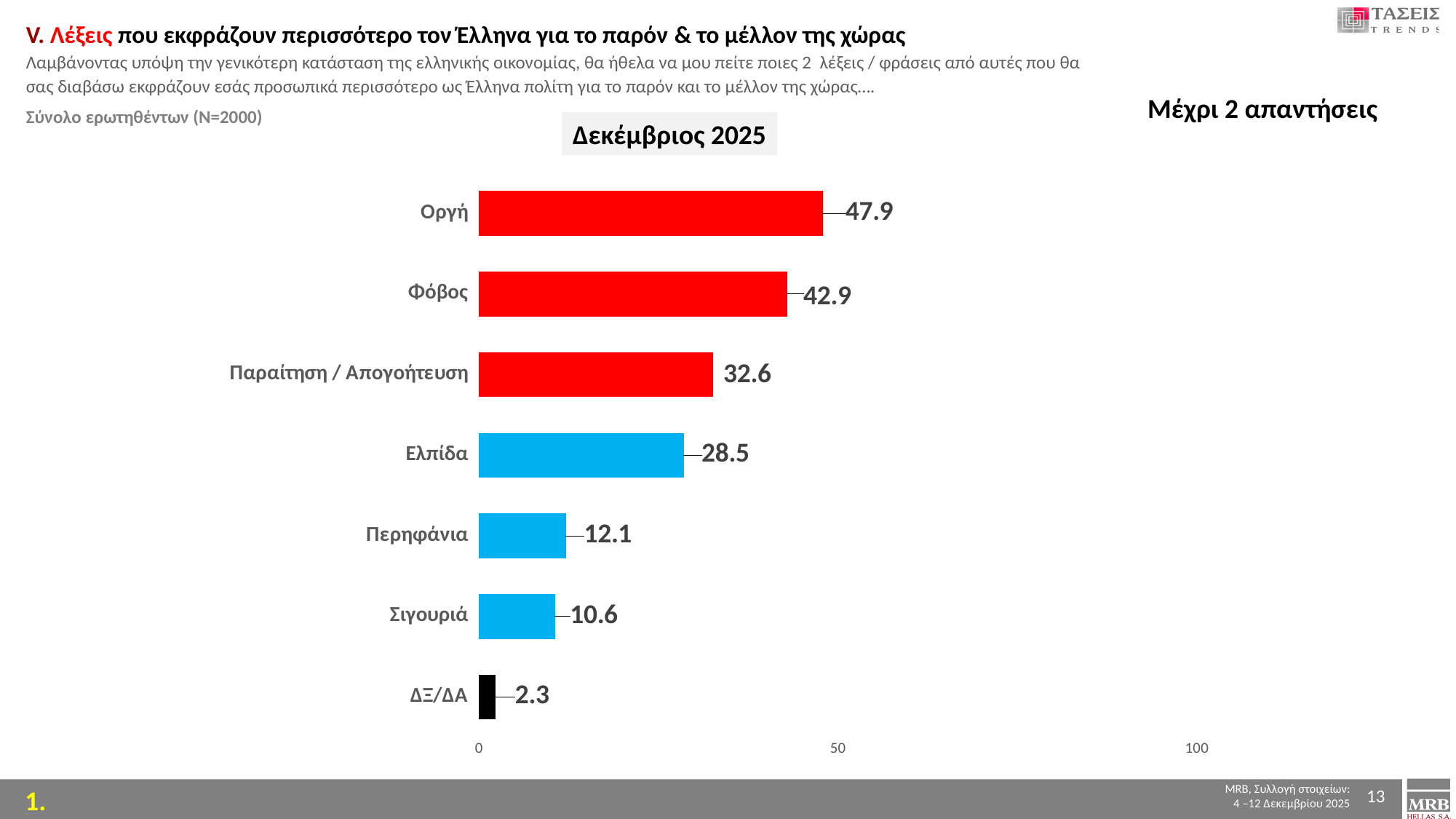
Which is larger, the value for Παραίτηση / Απογοήτευση or the value for Ελπίδα? Παραίτηση / Απογοήτευση What is the difference between the values for Οργή and Φόβος? 5.0 What is the value for Σιγουριά? 10.6 What kind of chart is shown on the slide? bar chart How many categories are shown in the chart? 7 Which category has the highest value? Οργή Is the value for Φόβος greater or less than 50? less What is the difference between the values for Περηφάνια and Σιγουριά? 1.5 What is the value for Ελπίδα? 28.5 What is the value for Οργή? 47.9 Which category has the lowest value? ΔΞ/ΔΑ What is the title shown above the chart? Δεκέμβριος 2025